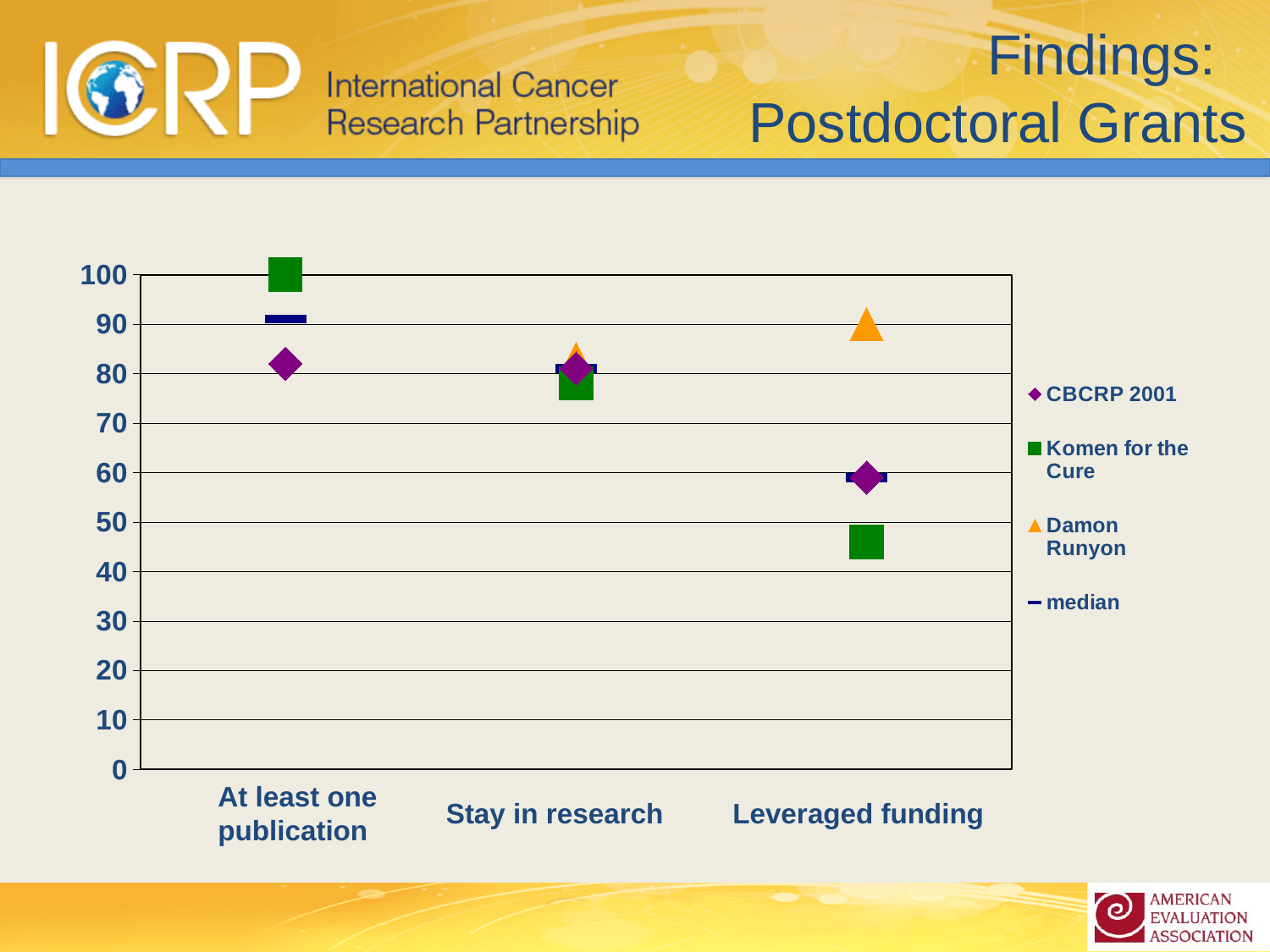
What kind of chart is shown on the slide? scatter chart Is the value for CBCRP 2001 at At least one publication greater or less than 70? greater How many categories are shown on the x axis? 3 In which category does Komen for the Cure have its lowest value? Leveraged funding Is the value for Damon Runyon at Leveraged funding greater or less than 80? greater Do the Komen for the Cure values rise or fall from At least one publication to Leveraged funding? fall In which category does Komen for the Cure have its highest value? At least one publication For At least one publication, which is higher: Komen for the Cure or CBCRP 2001? Komen for the Cure How many series does the legend list? 4 Is the value for Komen for the Cure at Leveraged funding greater or less than 50? less What marker shape represents Damon Runyon in the legend? triangle For Leveraged funding, which is higher: Damon Runyon or Komen for the Cure? Damon Runyon